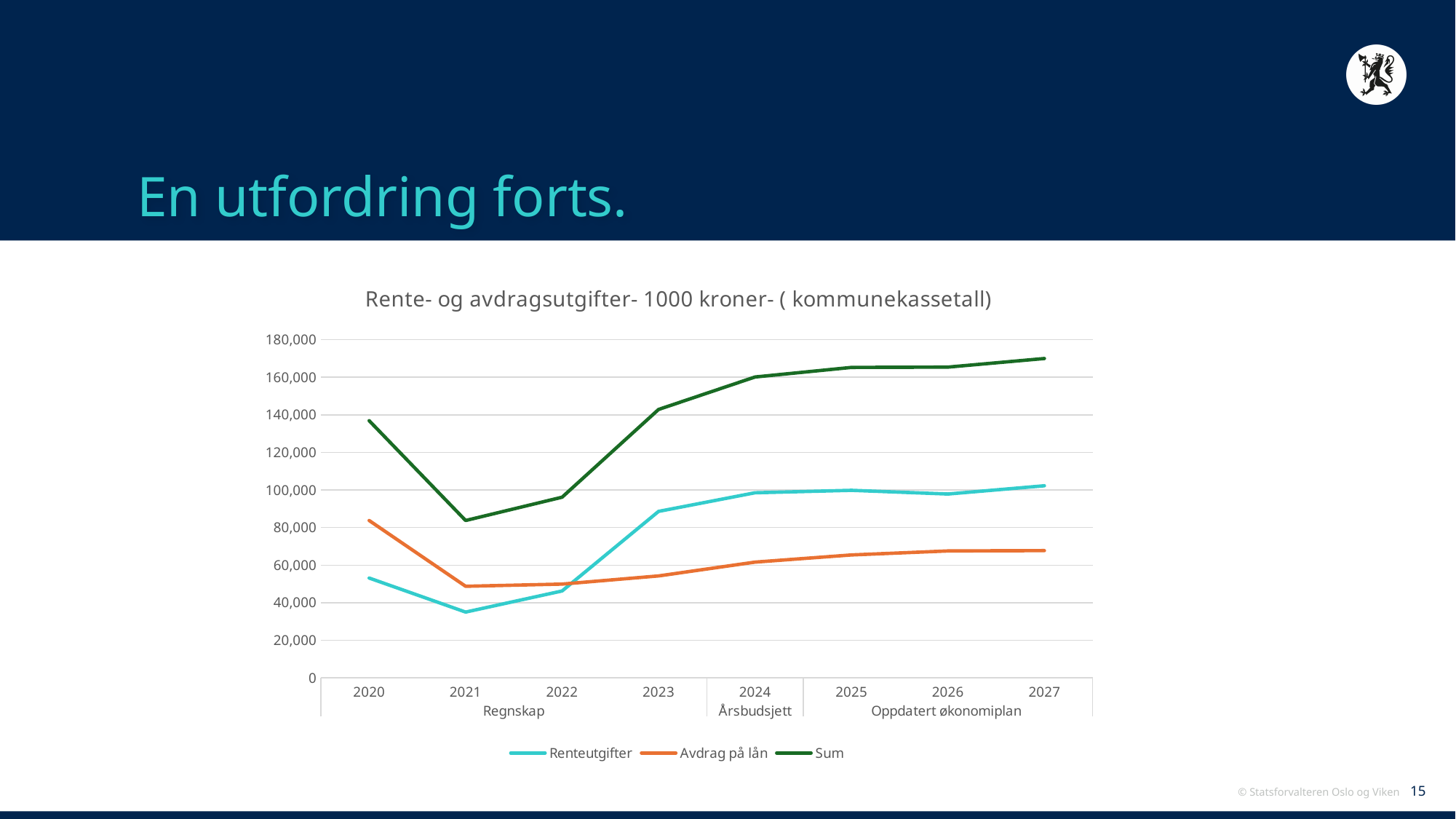
In 2023, which is larger: Renteutgifter or Avdrag på lån? Renteutgifter In which year is the Sum series at its highest? 2027 Is the value for Renteutgifter in 2021 greater or less than 40,000? less How many series does the legend list? 3 In which year is the Sum series at its lowest? 2021 Is the value for Sum in 2027 greater or less than 160,000? greater Is the value for Sum in 2020 greater or less than 120,000? greater In 2020, which is larger: Renteutgifter or Avdrag på lån? Avdrag på lån Does the Sum series rise or fall from 2021 to 2027? rise What kind of chart is shown on the slide? line chart How many years are plotted along the x axis? 8 In which year is the Renteutgifter series at its lowest? 2021